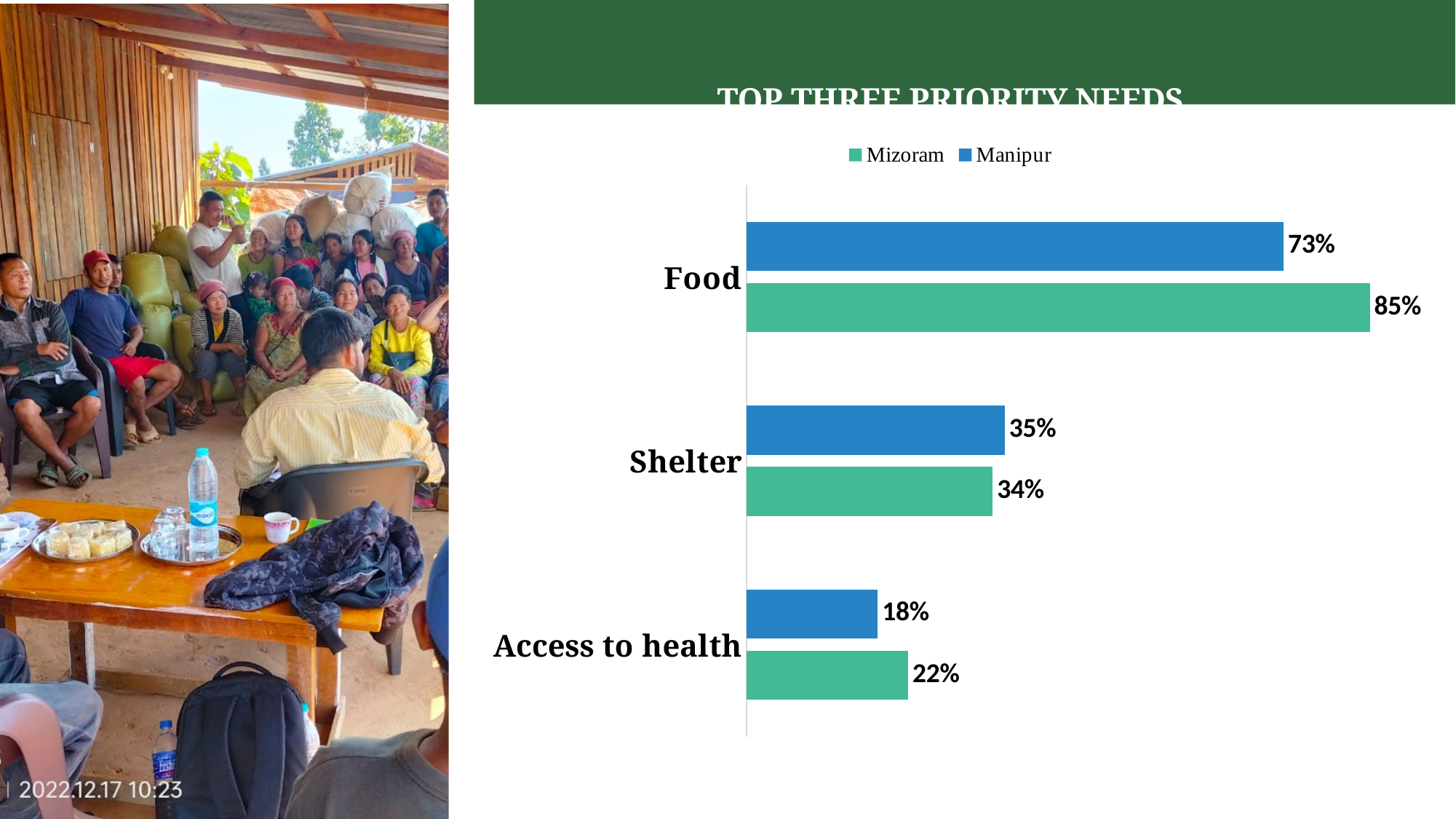
What is the difference between the Mizoram and Manipur values for Access to health? 4% Which priority need has the highest value for Manipur? Food How many priority needs are shown on the chart? 3 What is the difference between the Mizoram and Manipur values for Food? 12% Which colour represents Manipur in the chart? Blue For Food, which state has the larger value, Mizoram or Manipur? Mizoram What is the value for Manipur for Access to health? 18% Which priority need has the lowest value for Mizoram? Access to health How many series does the legend list? 2 What kind of chart is shown on the slide? Bar chart What is the value for Manipur for Shelter? 35% What percentage of respondents in Mizoram cited Food as a priority need? 85%